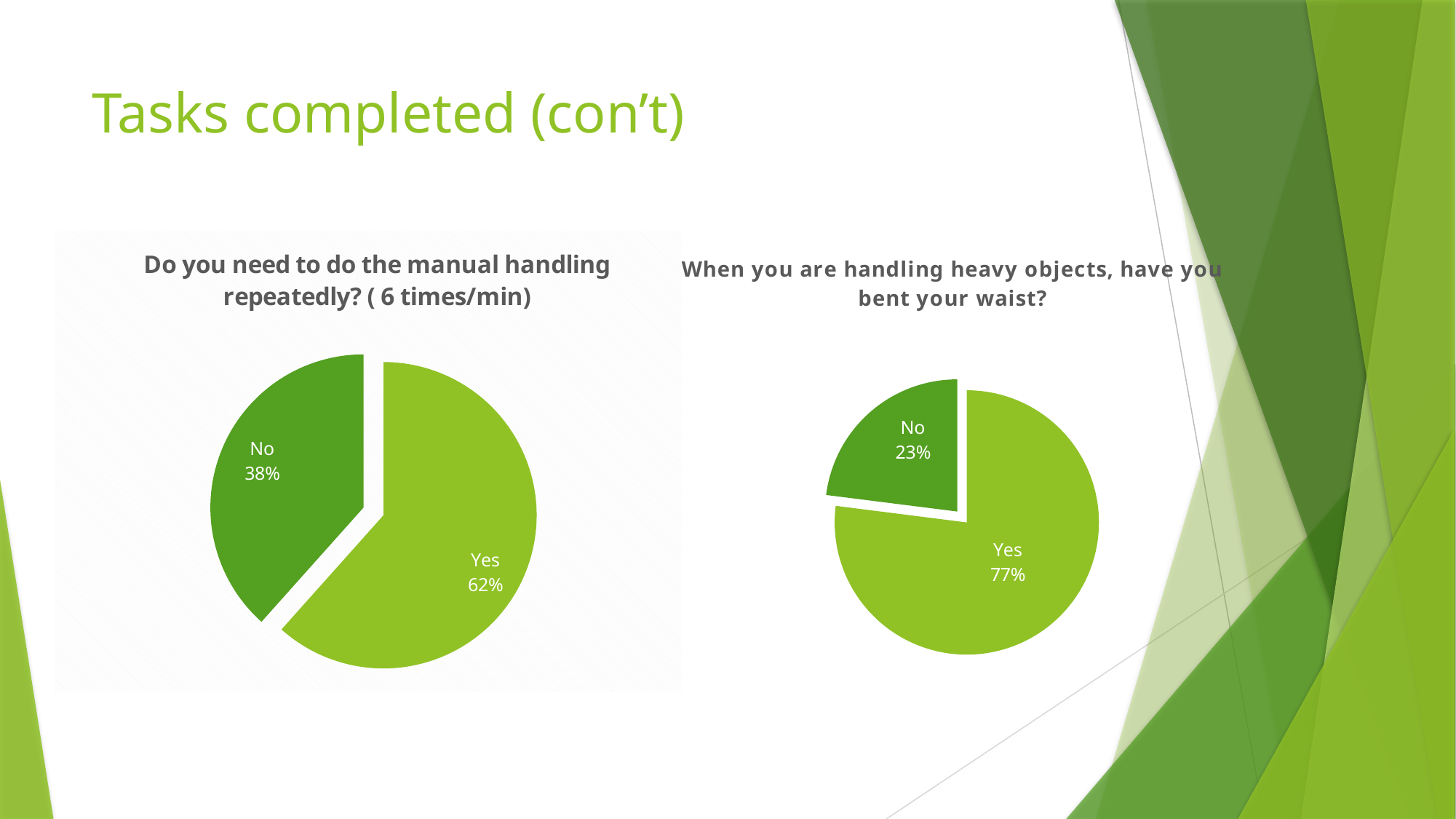
What type of chart is used on the left of the slide? pie chart How many slices does the right chart have? 2 In the right chart ("When you are handling heavy objects, have you bent your waist?"), what percentage answered No? 23% In the left chart ("Do you need to do the manual handling repeatedly?"), what percentage answered Yes? 62% In the left chart ("Do you need to do the manual handling repeatedly?"), what percentage answered No? 38% In the left chart, what is the difference in percentage points between Yes and No? 24 In the right chart, what is the difference in percentage points between Yes and No? 54 Is the Yes share in the right chart larger or smaller than the Yes share in the left chart? larger In the right chart, which response has the smaller share? No In the right chart ("When you are handling heavy objects, have you bent your waist?"), what percentage answered Yes? 77% What is the title of the right chart? When you are handling heavy objects, have you bent your waist? In the left chart, which response has the larger share? Yes